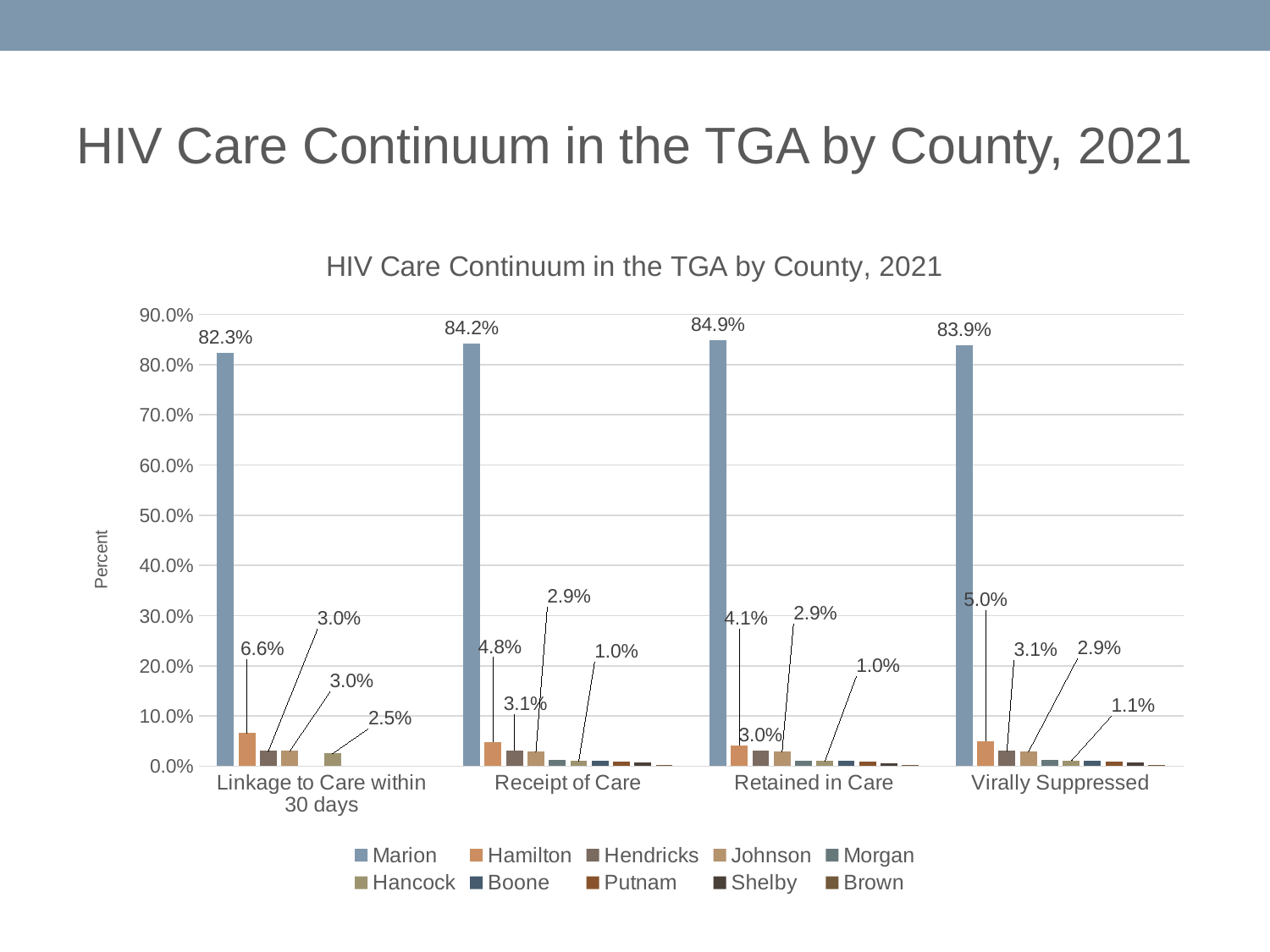
What is the difference between Marion's value for Retained in Care and its value for Linkage to Care within 30 days? 2.6 percentage points Which is larger for Hamilton: the value for Linkage to Care within 30 days or the value for Virally Suppressed? Linkage to Care within 30 days What kind of chart is shown on the slide? bar chart What is the value for Hamilton in the Linkage to Care within 30 days category? 6.6% In which category does Marion have its highest value? Retained in Care In which category does Marion have its lowest value? Linkage to Care within 30 days What is the value for Hamilton in the Virally Suppressed category? 5.0% What is the value for Marion in the Retained in Care category? 84.9% How many series does the legend list? 10 What is the value for Marion in the Linkage to Care within 30 days category? 82.3% Is the value for Marion in the Receipt of Care category greater or less than 80.0%? greater How many categories are shown on the x axis? 4